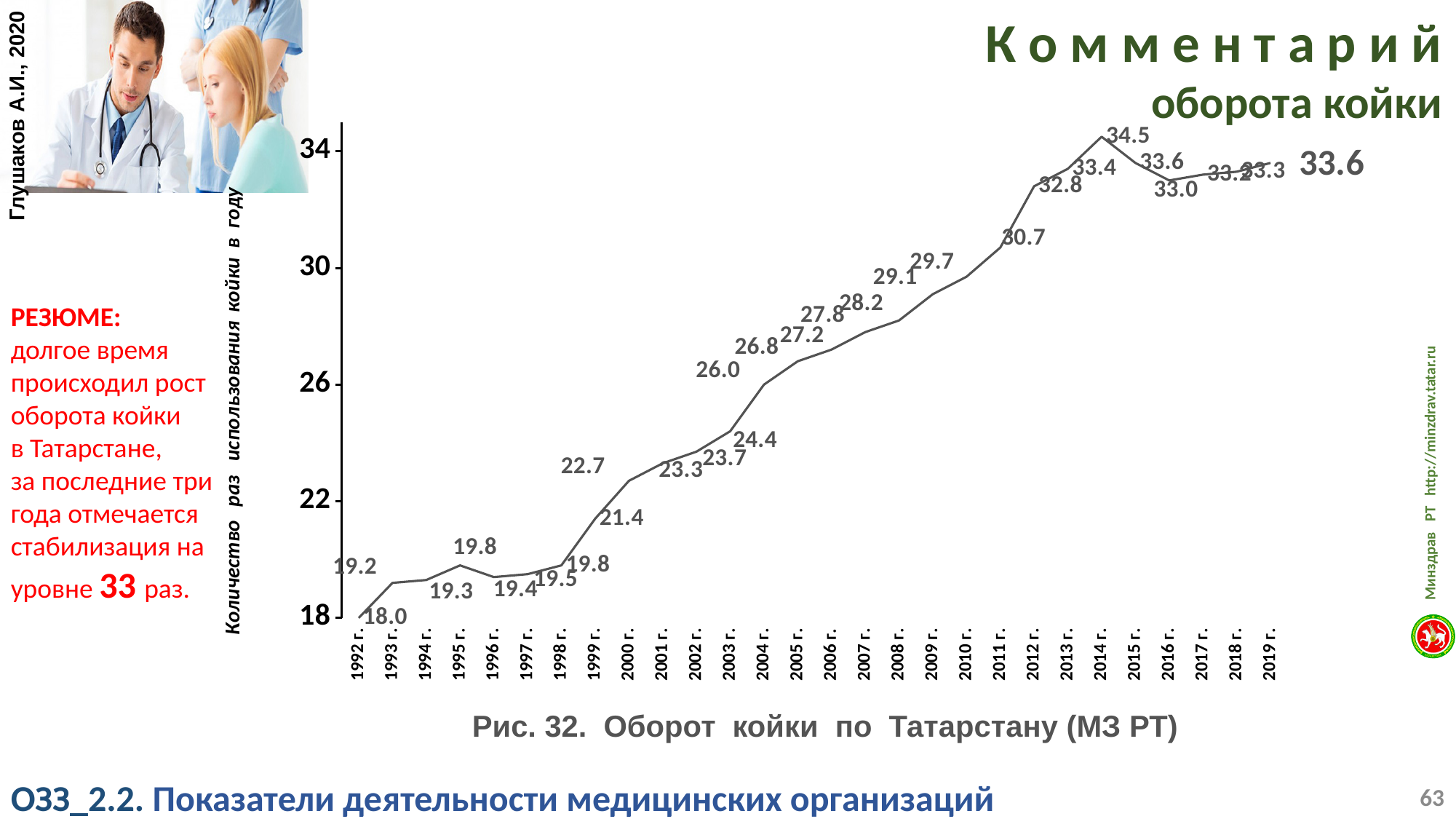
What is the bed turnover value for 2011 (2011 г.)? 30.7 What is the overall trend of bed turnover from 1992 to 2014? rising What is the bed turnover value for 1992 (1992 г.)? 18.0 Which year has the lowest bed turnover value? 1992 г. What is the difference between the bed turnover values for 2014 and 1992? 16.5 What is the bed turnover value for 2004 (2004 г.)? 26.0 How many years are plotted on the x axis? 28 What is the bed turnover value for 2014 (2014 г.)? 34.5 Is the value for 2010 greater or less than 30? less What type of chart is shown on the slide? line chart Which year has the highest bed turnover value? 2014 г. Which year has a larger bed turnover value, 1999 or 2000? 2000 г.